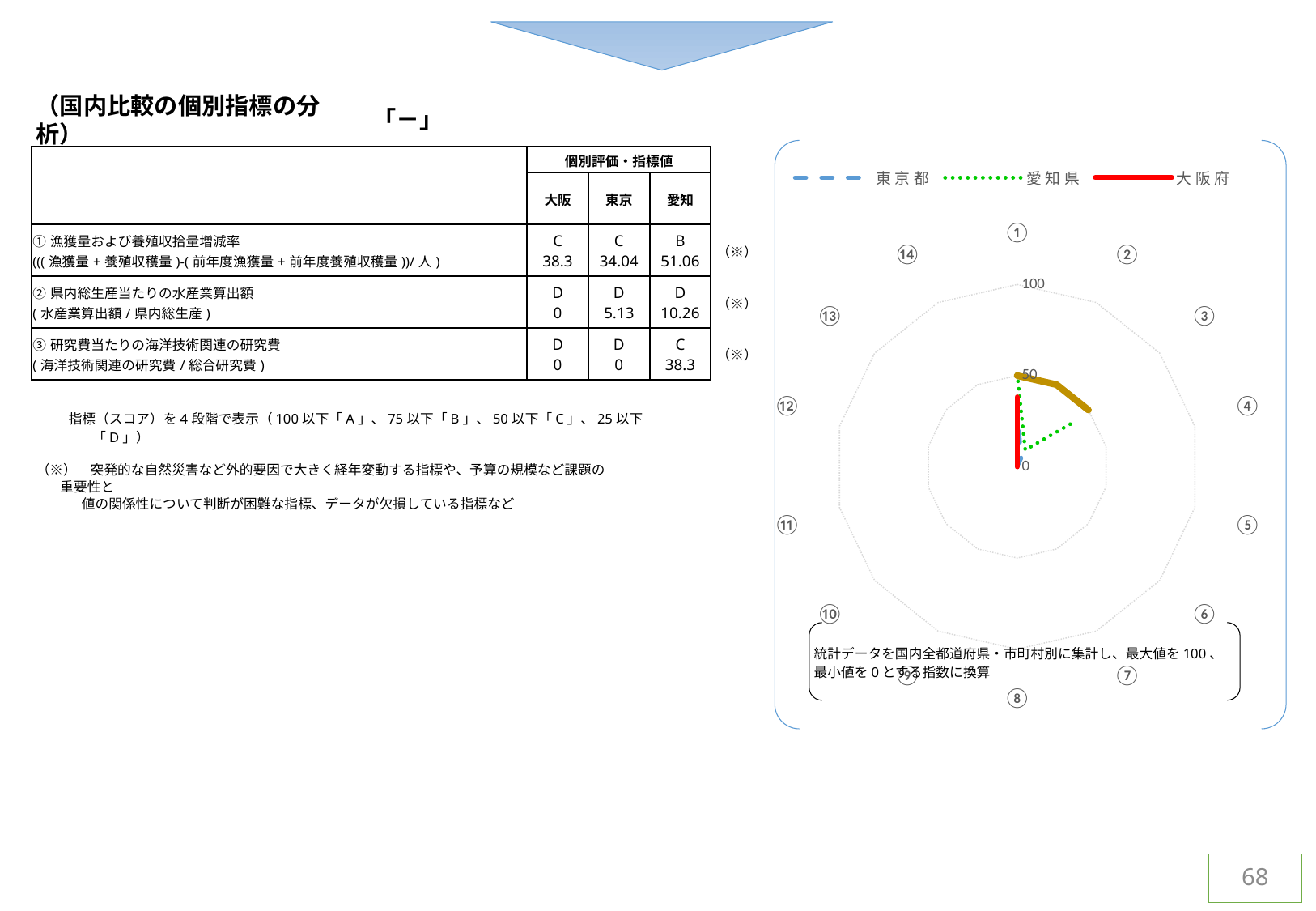
In the radar chart, is the value for 愛知県 on axis ③ greater or less than 50? less Which series in the radar chart legend is drawn as a green dotted line? 愛知県 Which series in the radar chart legend is drawn as a solid red line? 大阪府 What kind of chart is shown on the right side of the slide? radar chart In the radar chart, is the value for 大阪府 on axis ① greater or less than 50? less In the radar chart, is the value for 愛知県 on axis ② greater or less than 50? less In the radar chart, which is larger for 愛知県: the value on axis ① or the value on axis ②? axis ① How many series does the legend of the radar chart list? 3 What is the maximum value shown on the radar chart's scale? 100 How many numbered axes does the radar chart have? 14